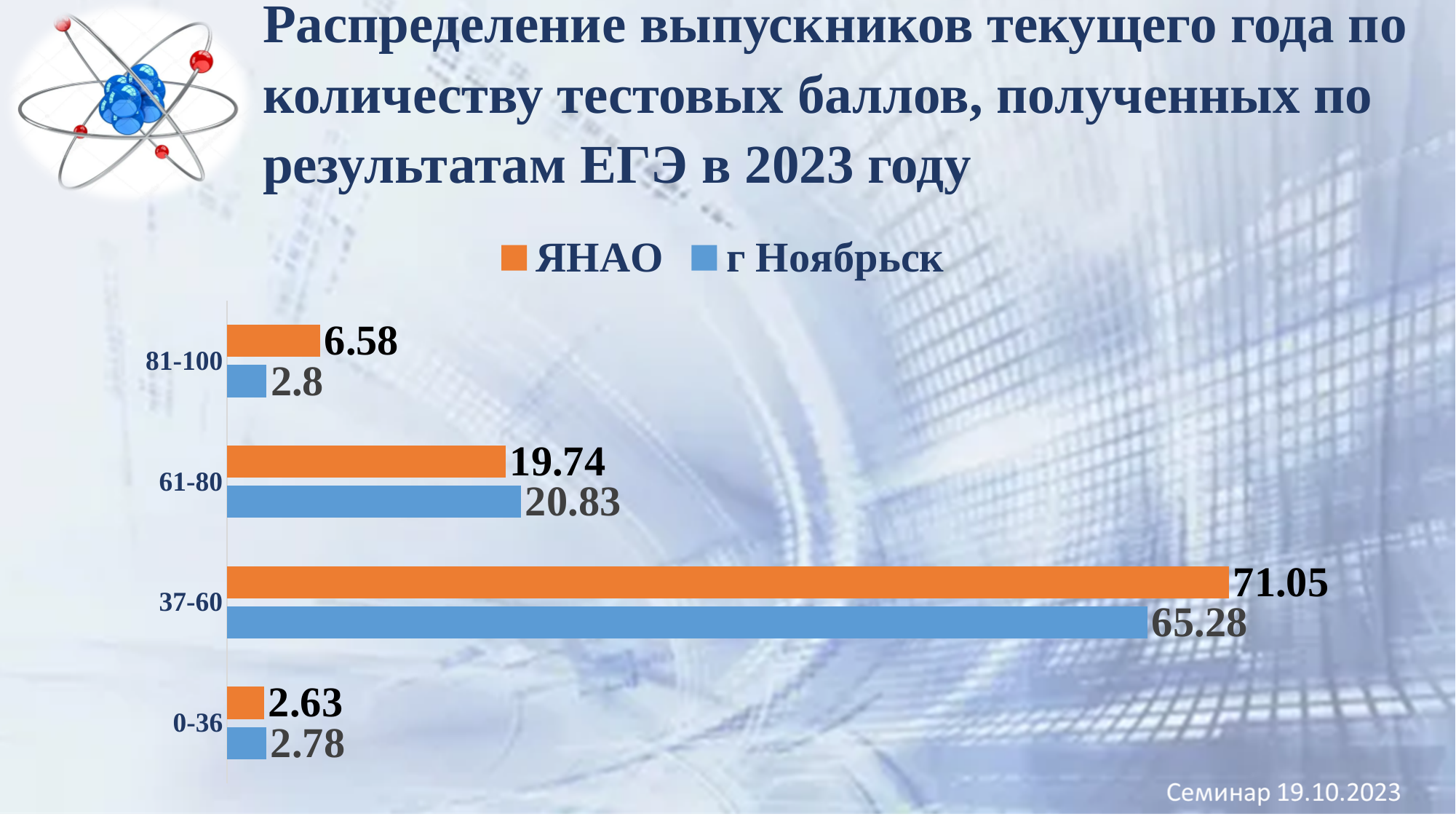
Which score range has the highest value for г Ноябрьск? 37-60 What is the value for ЯНАО in the 0-36 score range? 2.63 What kind of chart is shown on the slide? Bar chart Which score range has the lowest value for ЯНАО? 0-36 What is the value for г Ноябрьск in the 81-100 score range? 2.8 What is the difference between the ЯНАО and г Ноябрьск values in the 81-100 score range? 3.78 How many score ranges are shown on the chart? 4 What is the value for г Ноябрьск in the 61-80 score range? 20.83 What is the value for ЯНАО in the 37-60 score range? 71.05 How many series does the legend list? 2 In the 61-80 score range, which series has the larger value, ЯНАО or г Ноябрьск? г Ноябрьск What is the difference between the ЯНАО and г Ноябрьск values in the 37-60 score range? 5.77